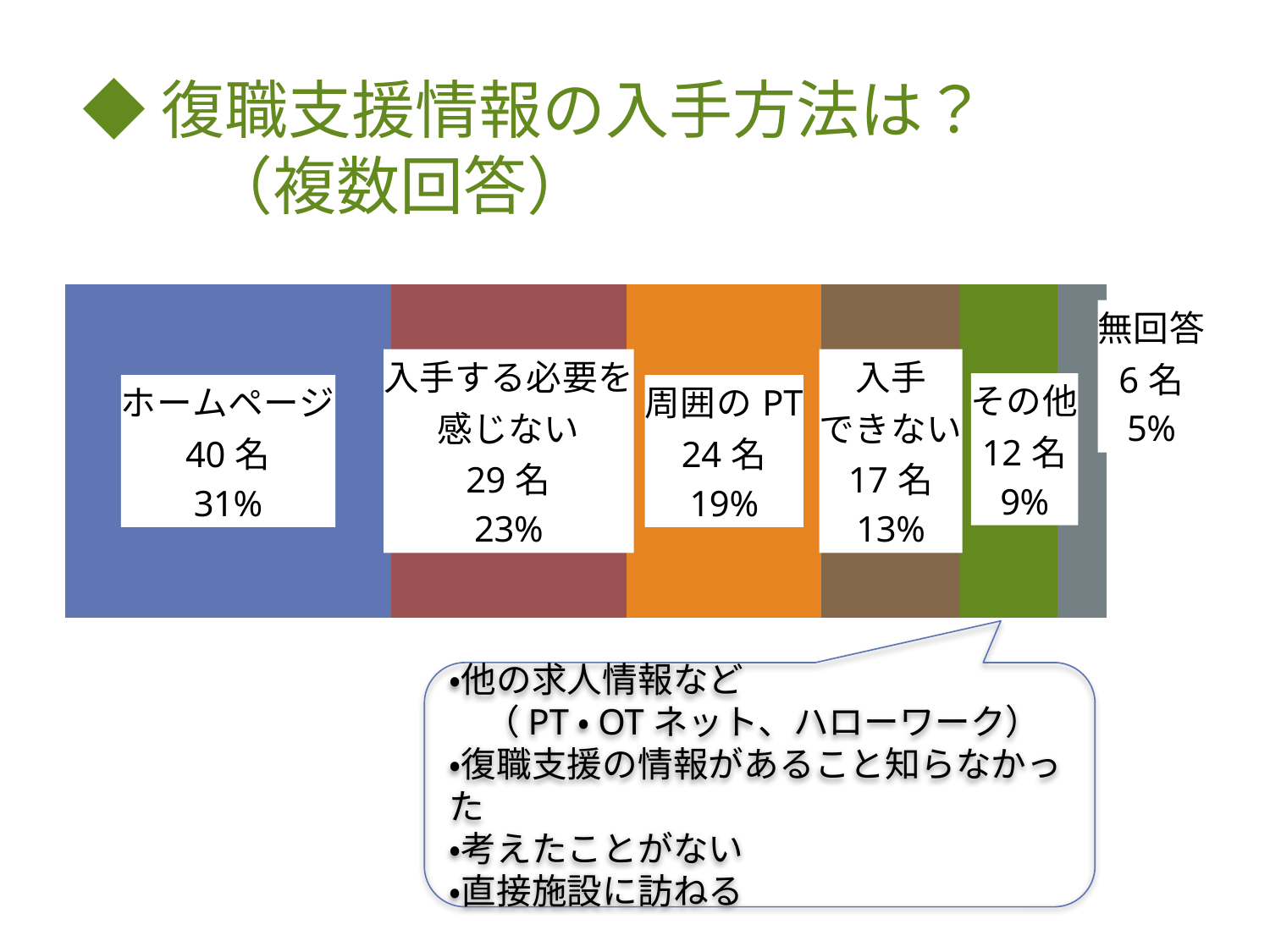
Which has more respondents, 周囲のPT or その他? 周囲のPT Which segment has the largest number of respondents? ホームページ What is the difference in respondents between ホームページ and 入手する必要を感じない? 11名 Which segment has the smallest number of respondents? 無回答 What percentage is shown for 無回答? 5% How many respondents chose ホームページ? 40名 What kind of chart is shown on the slide? Stacked bar chart How many respondents are in the 入手できない segment? 17名 What colour is the ホームページ segment? Blue What is the total number of respondents across all segments of the bar? 128名 How many segments does the stacked bar contain? 6 What percentage is shown for 周囲のPT? 19%